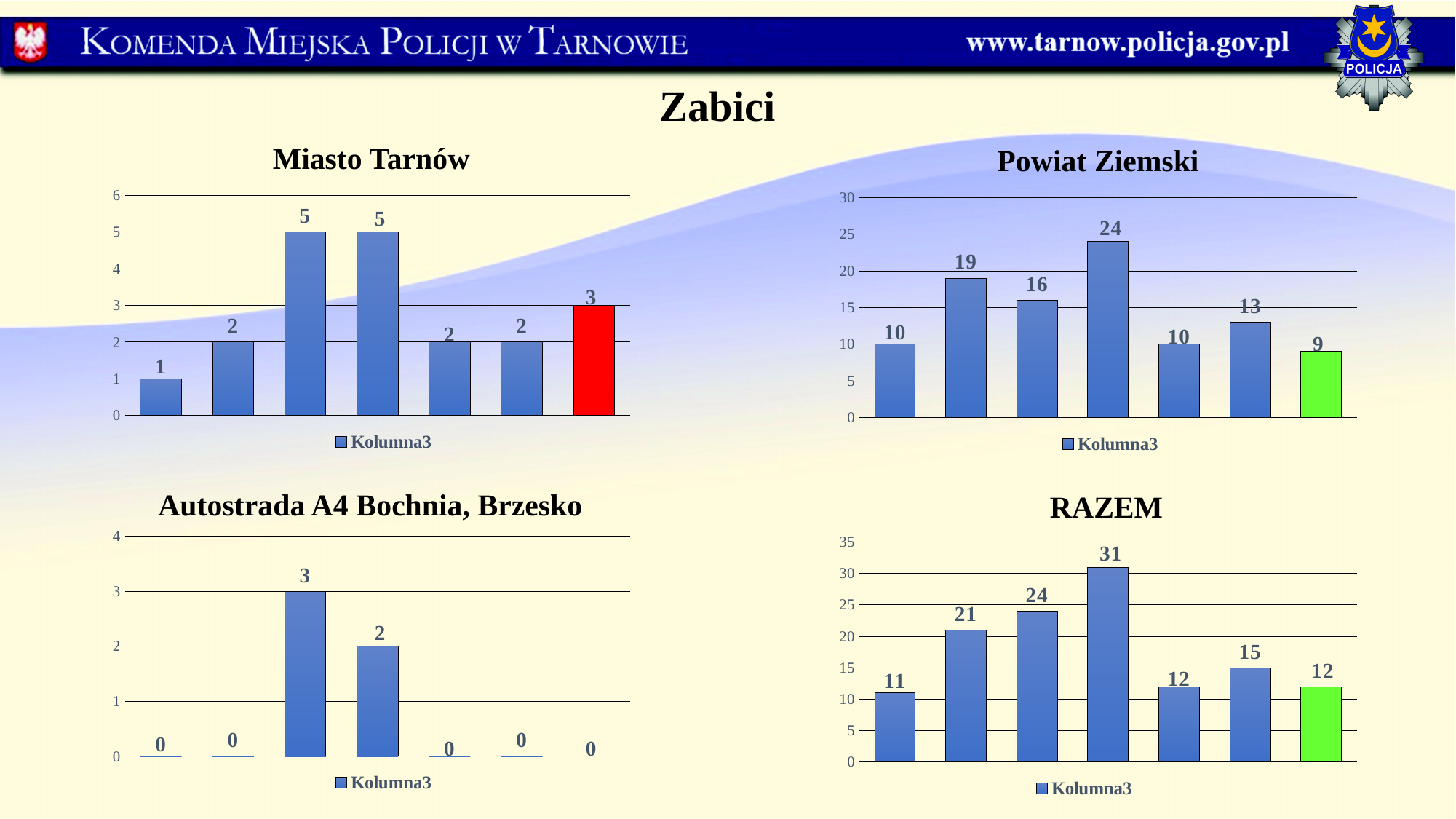
How many bars are plotted in the Autostrada A4 Bochnia, Brzesko chart? 7 In the RAZEM chart, what is the value of the first bar? 11 In the RAZEM chart, what is the difference between the highest bar and the last (green) bar? 19 In the Autostrada A4 Bochnia, Brzesko chart, what is the value of the third bar? 3 In the Powiat Ziemski chart, what is the lowest value shown? 9 In the Powiat Ziemski chart, which is larger, the first bar or the last bar? the first bar What type of chart is the RAZEM chart? bar chart In the Miasto Tarnów chart, what is the value of the last (red) bar? 3 In the Powiat Ziemski chart, what is the highest value shown? 24 How many series does the legend of the Miasto Tarnów chart list? 1 In the Miasto Tarnów chart, what is the value of the first bar? 1 In the RAZEM chart, what is the highest value shown? 31